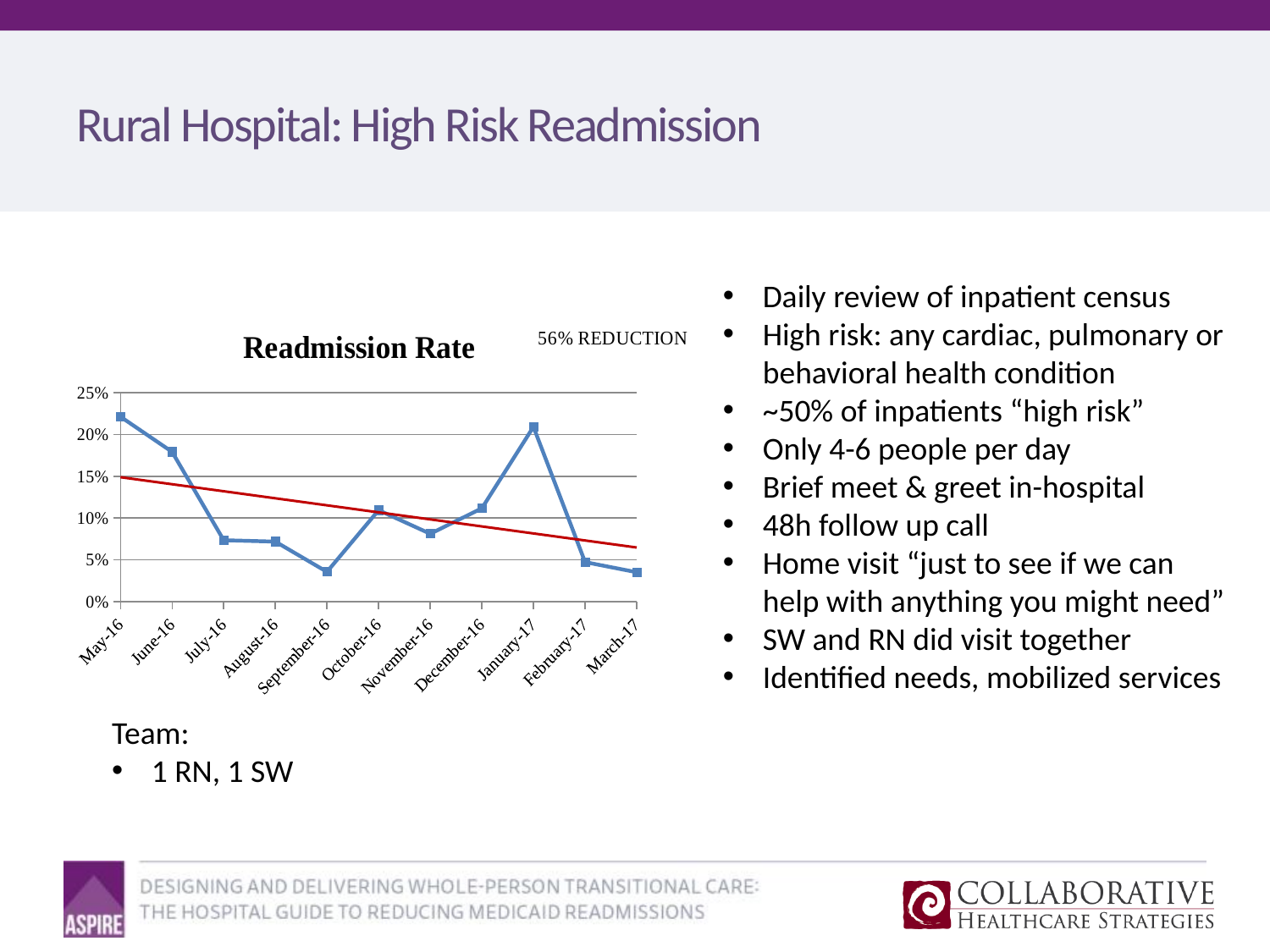
Which month has a higher readmission rate, January-17 or February-17? January-17 How many months are plotted on the x axis of the chart? 11 Is the readmission rate for March-17 greater or less than 5%? less What kind of chart is shown on the slide? line chart Which month has a higher readmission rate, June-16 or July-16? June-16 Is the readmission rate for January-17 greater or less than 15%? greater Is the readmission rate for May-16 greater or less than 20%? greater According to the red trend line, does the readmission rate rise or fall from May-16 to March-17? fall What is the title of the chart? Readmission Rate What percentage reduction is noted next to the chart title? 56% REDUCTION